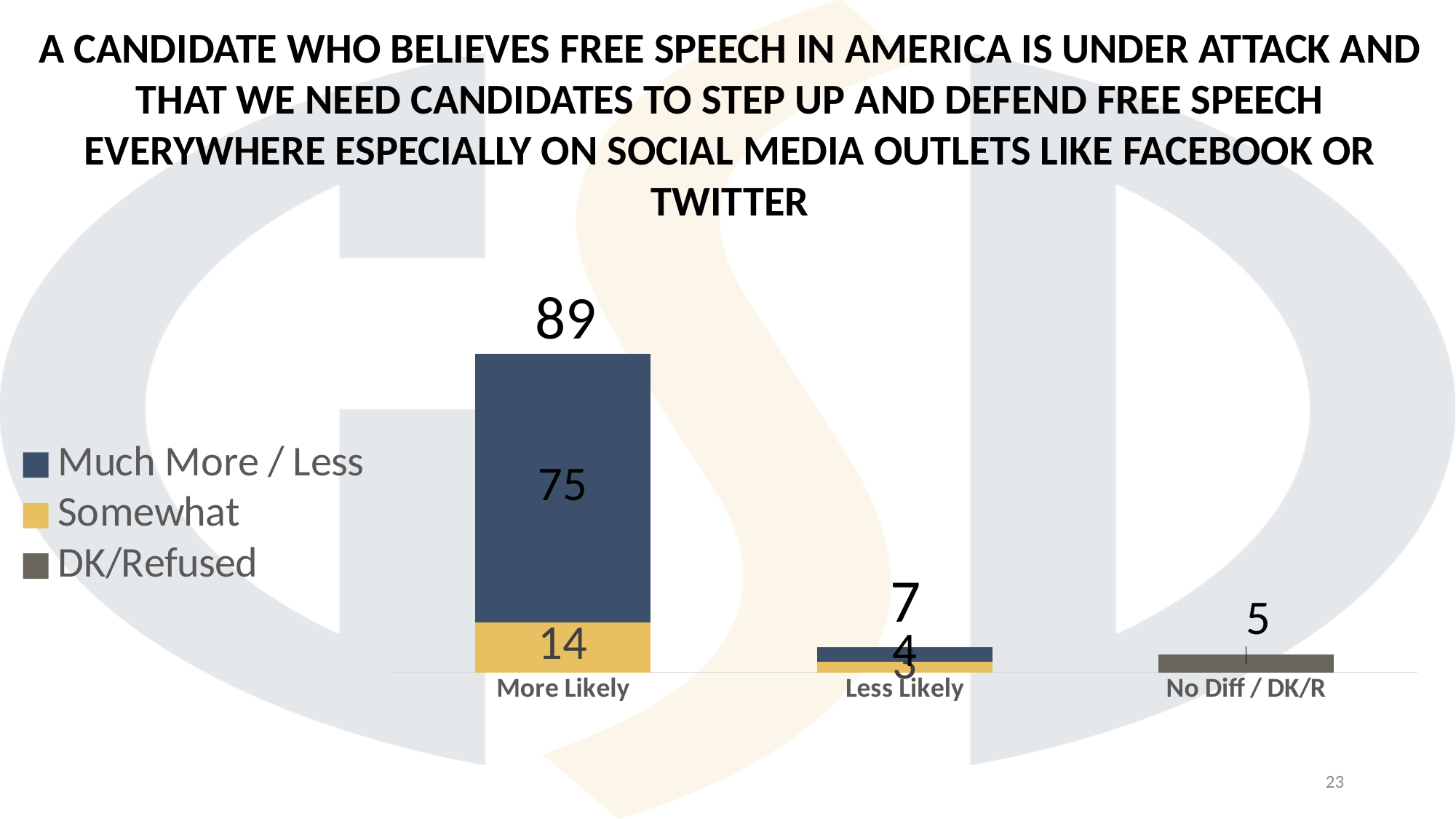
What is the Much More / Less value for Less Likely? 4 What is the total value shown above the More Likely bar? 89 How many series does the legend list? 3 What is the value for No Diff / DK/R? 5 Which category has the lowest total? No Diff / DK/R Which category has the highest total? More Likely What is the Much More / Less value for More Likely? 75 What is the total value shown above the Less Likely bar? 7 What is the difference between the More Likely total and the Less Likely total? 82 How many categories are shown on the x axis? 3 What is the Somewhat value for More Likely? 14 Which is larger, the Less Likely total or the No Diff / DK/R value? Less Likely